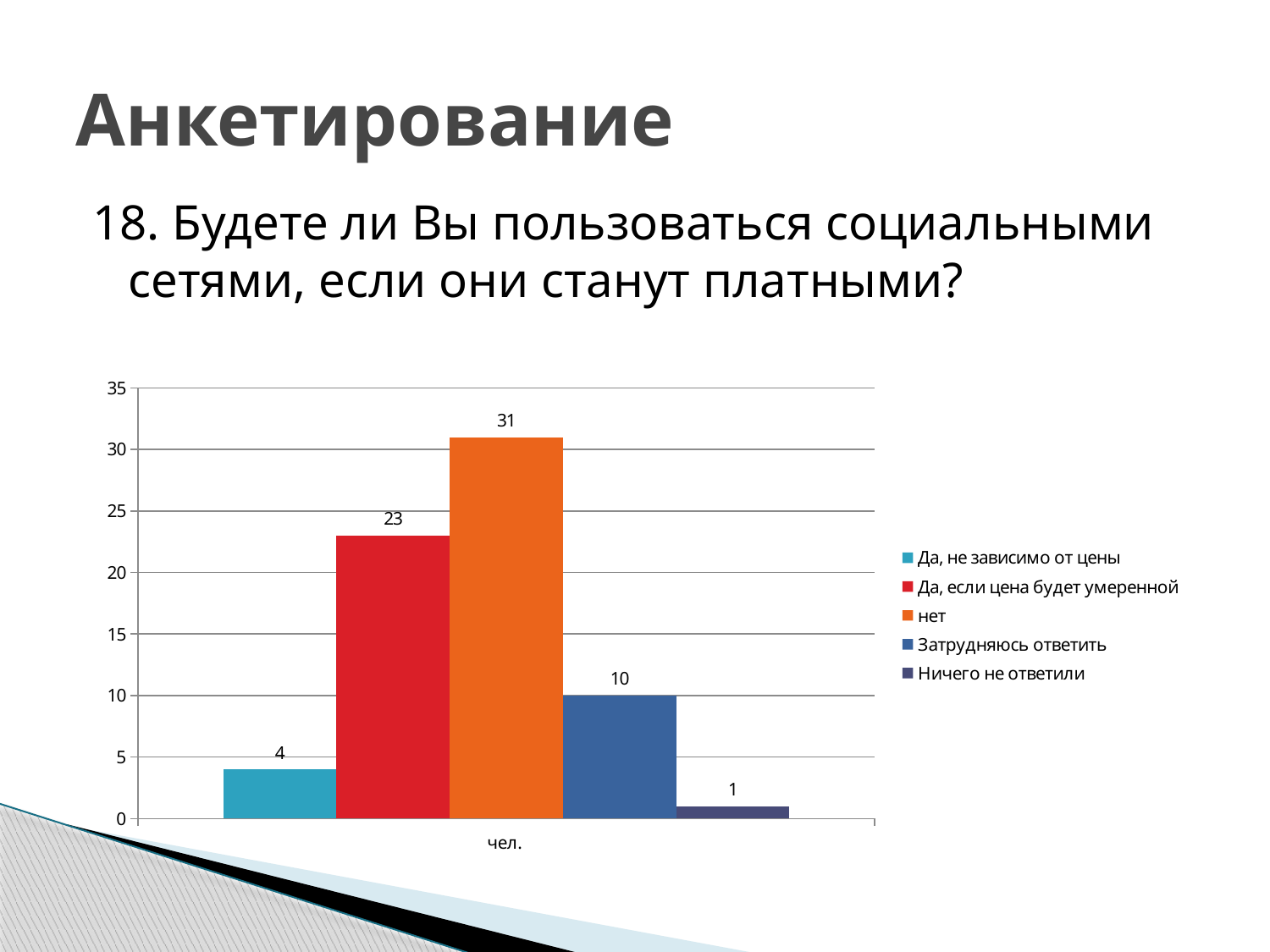
Is the value for "нет" greater or less than 30? greater What is the value for "Затрудняюсь ответить"? 10 What is the label shown on the x axis of the chart? чел. What is the value for "Да, если цена будет умеренной"? 23 What is the value for "нет"? 31 Which is larger: the value for "Затрудняюсь ответить" or the value for "Да, не зависимо от цены"? Затрудняюсь ответить What is the value for "Да, не зависимо от цены"? 4 What is the difference between the values for "нет" and "Да, если цена будет умеренной"? 8 What kind of chart is shown on the slide? bar chart How many series does the legend list? 5 Which series has the lowest value? Ничего не ответили Which series has the highest value? нет